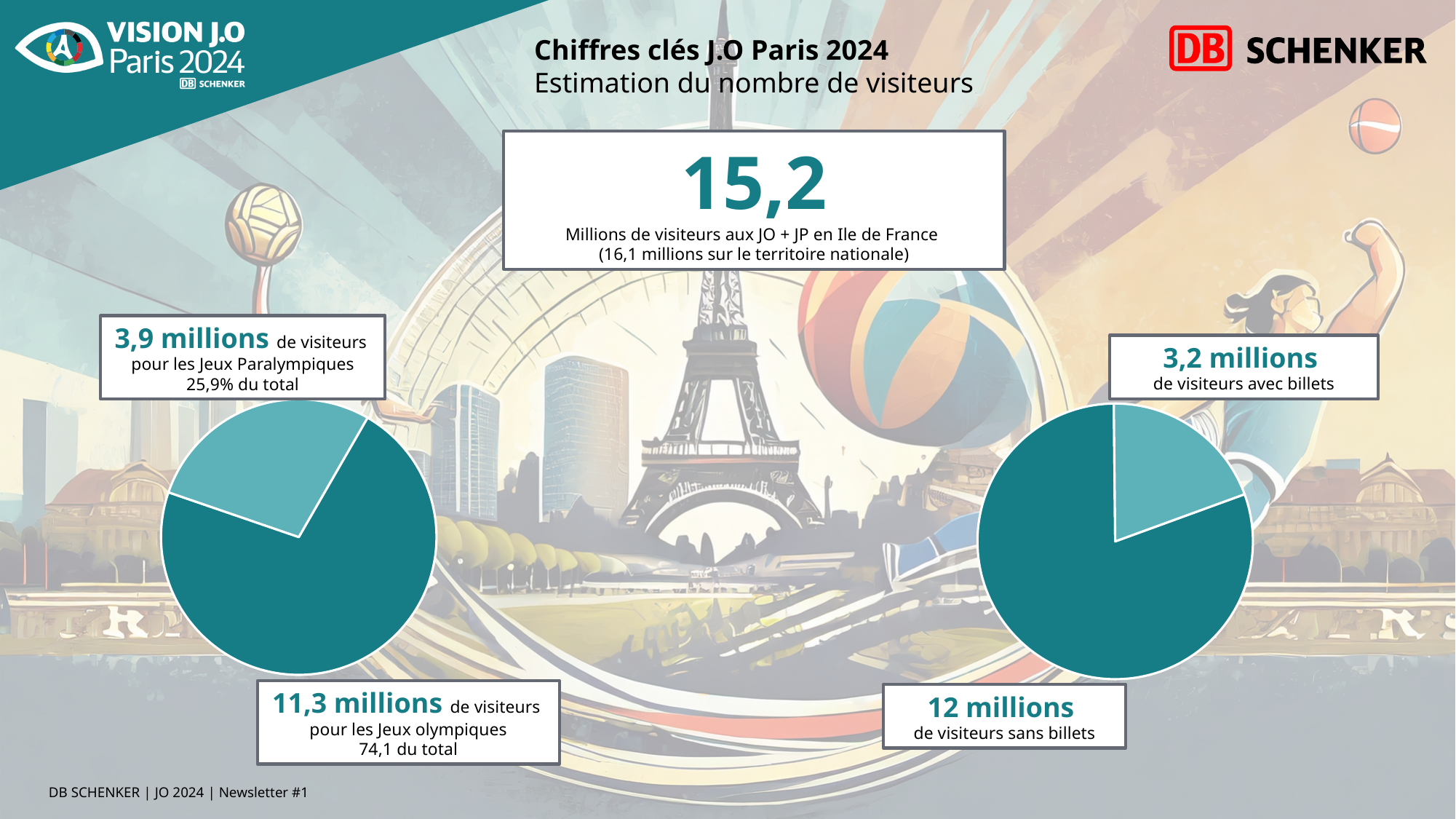
In the left pie chart, what share of the total do the Jeux Paralympiques visitors represent? 25,9% In the left pie chart, how many visitors are estimated for the Jeux olympiques? 11,3 millions What kind of chart is the right chart on the slide? pie chart In the left pie chart, how many visitors are estimated for the Jeux Paralympiques? 3,9 millions How many slices does the left pie chart have? 2 In the right pie chart, which slice is the largest? de visiteurs sans billets In the right pie chart, what is the difference in millions between visitors sans billets and visitors avec billets? 8,8 millions In the right pie chart, how many visitors are estimated to be without tickets (sans billets)? 12 millions What kind of chart is the left chart on the slide? pie chart In the left pie chart, what share of the total do the Jeux olympiques visitors represent? 74,1 In the right pie chart, how many visitors are estimated to have tickets (avec billets)? 3,2 millions In the left pie chart, which slice is larger: Jeux olympiques or Jeux Paralympiques? Jeux olympiques